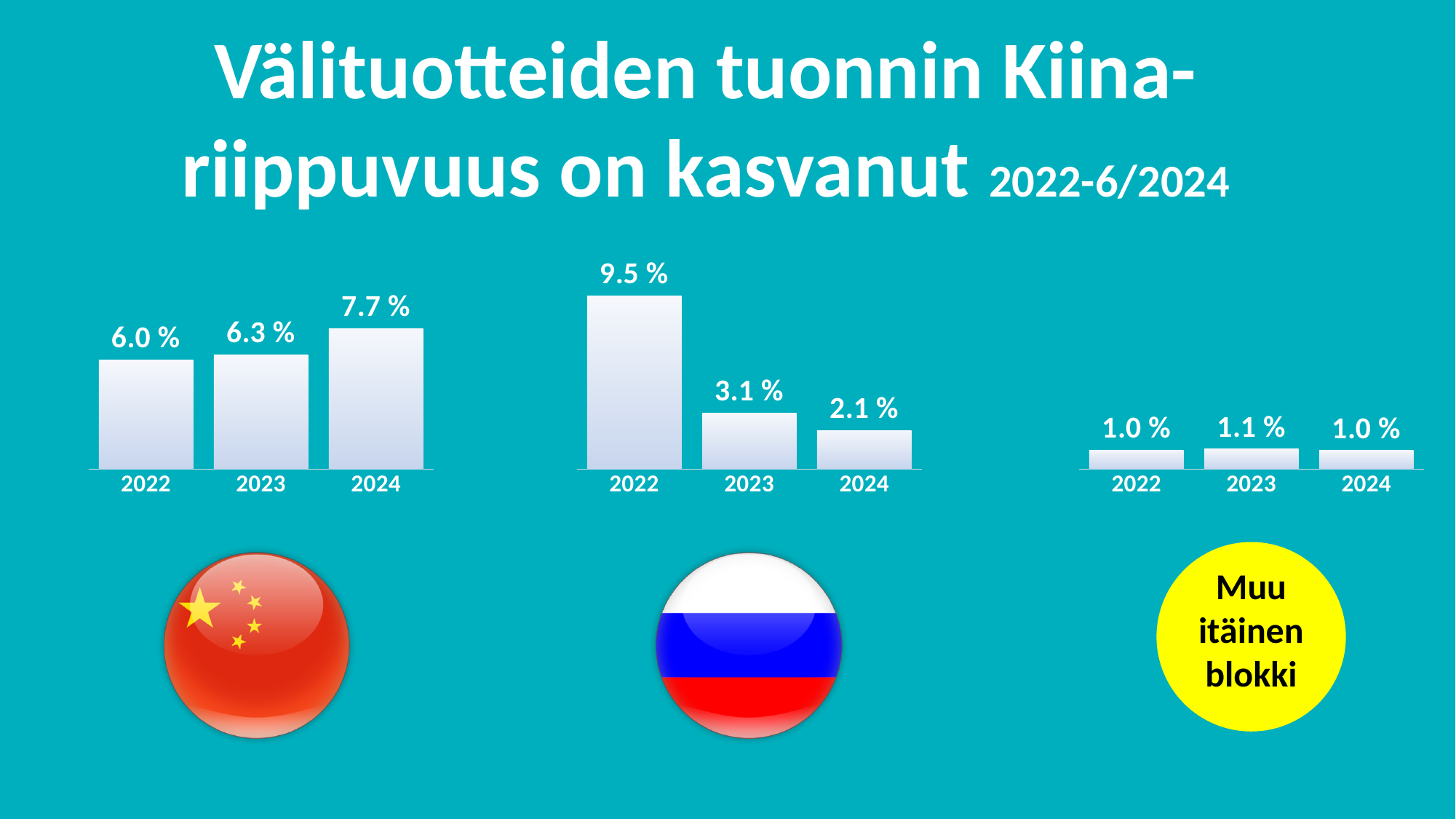
In the middle chart (above the Russian flag), do the values rise or fall from 2022 to 2024? Fall In the left chart (above the Chinese flag), what is the value for 2024? 7.7 % How many bars does the left chart (above the Chinese flag) have? 3 Which is larger: the 2022 value in the left chart (Chinese flag) or the 2022 value in the middle chart (Russian flag)? The middle chart (9.5 %) In the left chart (above the Chinese flag), do the values rise or fall from 2022 to 2024? Rise In the middle chart (above the Russian flag), what is the difference between the 2022 and 2023 values? 6.4 % In the middle chart (above the Russian flag), which year has the lowest value? 2024 In the left chart (above the Chinese flag), which year has the highest value? 2024 In the right chart (above 'Muu itäinen blokki'), what is the value for 2023? 1.1 % In the left chart (above the Chinese flag), what is the difference between the 2024 and 2022 values? 1.7 % In the middle chart (above the Russian flag), what is the value for 2022? 9.5 % What type of chart is used in the middle chart (above the Russian flag)? Bar chart